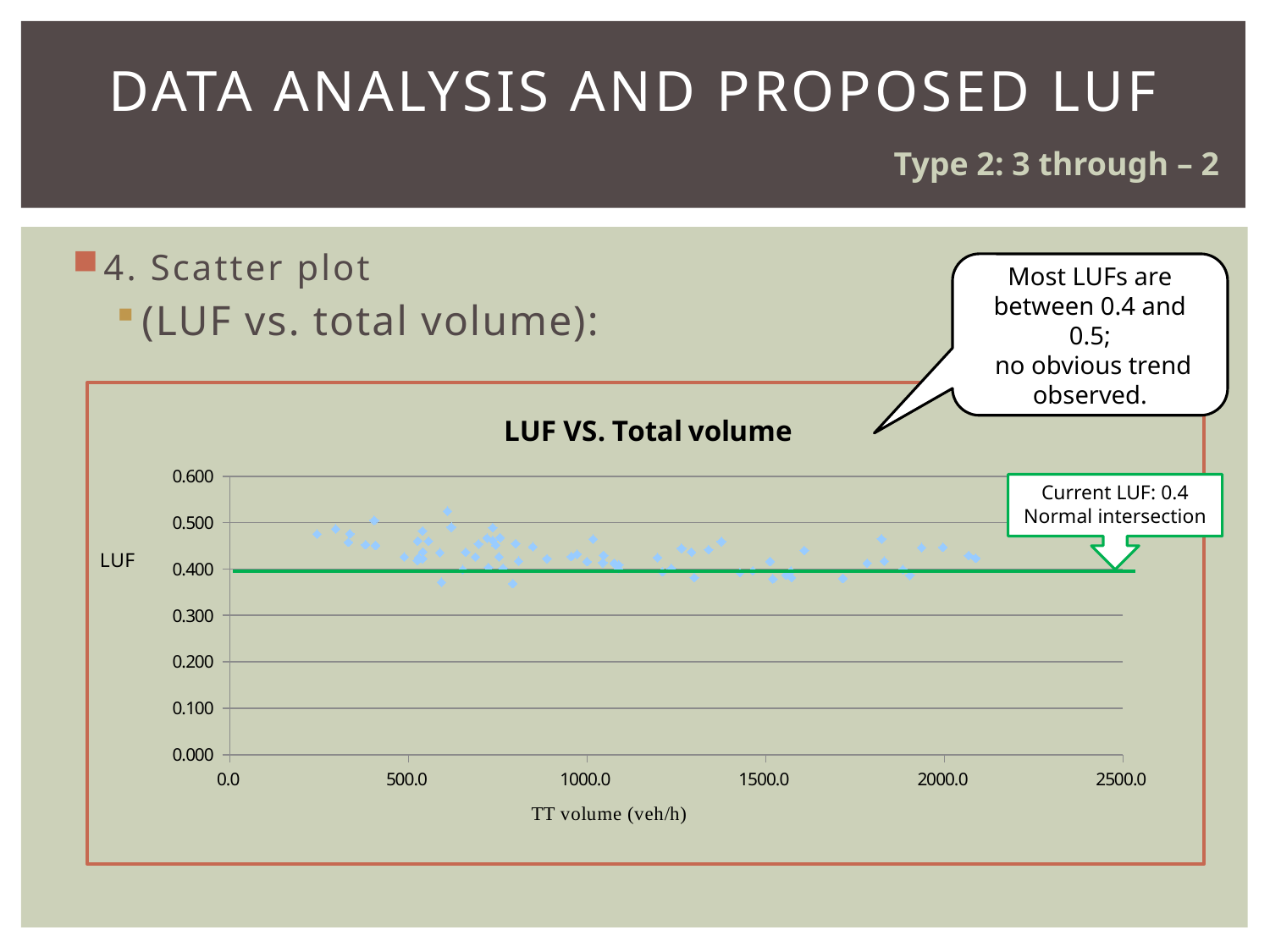
What kind of chart is shown on the slide? Scatter plot What is the title of the chart? LUF VS. Total volume Is the TT volume of the leftmost plotted point greater or less than 0.0? greater What is the label of the x axis of the chart? TT volume (veh/h) Are the plotted LUF values greater or less than 0.300? greater What is the highest tick value shown on the y axis of the chart? 0.600 Is the LUF value of every plotted point less or greater than 0.600? less What value does the green horizontal line in the chart represent, according to the annotation? 0.4 Do the LUF values show a clear rising or falling trend as TT volume increases along the x axis? No obvious trend